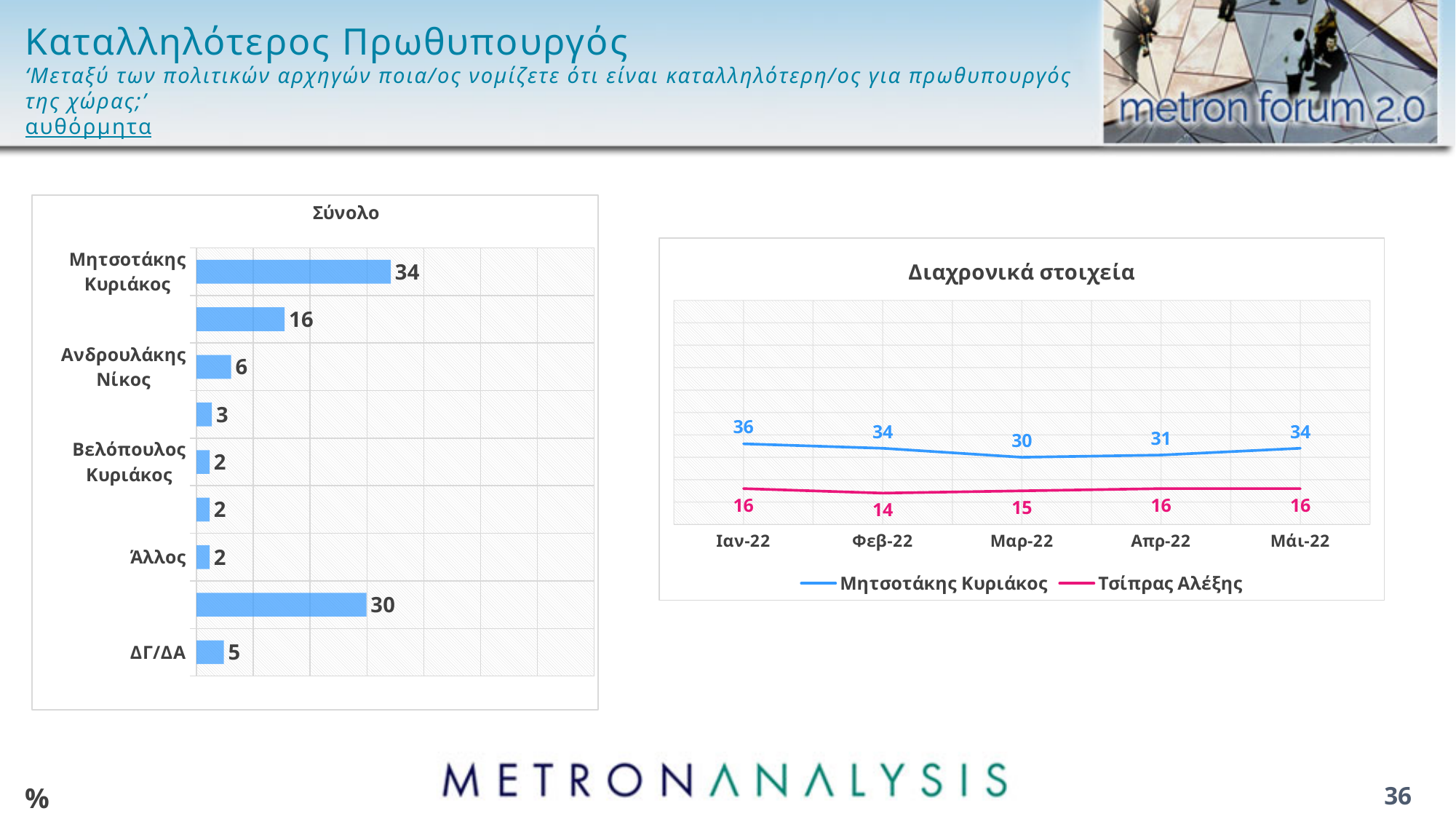
What kind of chart is the 'Σύνολο' chart? Bar chart In the 'Διαχρονικά στοιχεία' chart, what is the value for Μητσοτάκης Κυριάκος in Μαρ-22? 30 How many series does the legend of the 'Διαχρονικά στοιχεία' chart list? 2 In the 'Διαχρονικά στοιχεία' chart, what is the difference between Μητσοτάκης Κυριάκος and Τσίπρας Αλέξης in Μάι-22? 18 In the 'Σύνολο' chart, what is the value for Μητσοτάκης Κυριάκος? 34 In the 'Σύνολο' chart, how many bars are plotted? 9 In the 'Διαχρονικά στοιχεία' chart, in which month is the value for Μητσοτάκης Κυριάκος highest? Ιαν-22 In the 'Διαχρονικά στοιχεία' chart, what is the value for Τσίπρας Αλέξης in Φεβ-22? 14 In the 'Σύνολο' chart, what is the value for Ανδρουλάκης Νίκος? 6 In the 'Σύνολο' chart, which labelled category has the highest value? Μητσοτάκης Κυριάκος In the 'Σύνολο' chart, what is the difference between the values for Μητσοτάκης Κυριάκος and Ανδρουλάκης Νίκος? 28 In the 'Σύνολο' chart, what is the value for ΔΓ/ΔΑ? 5